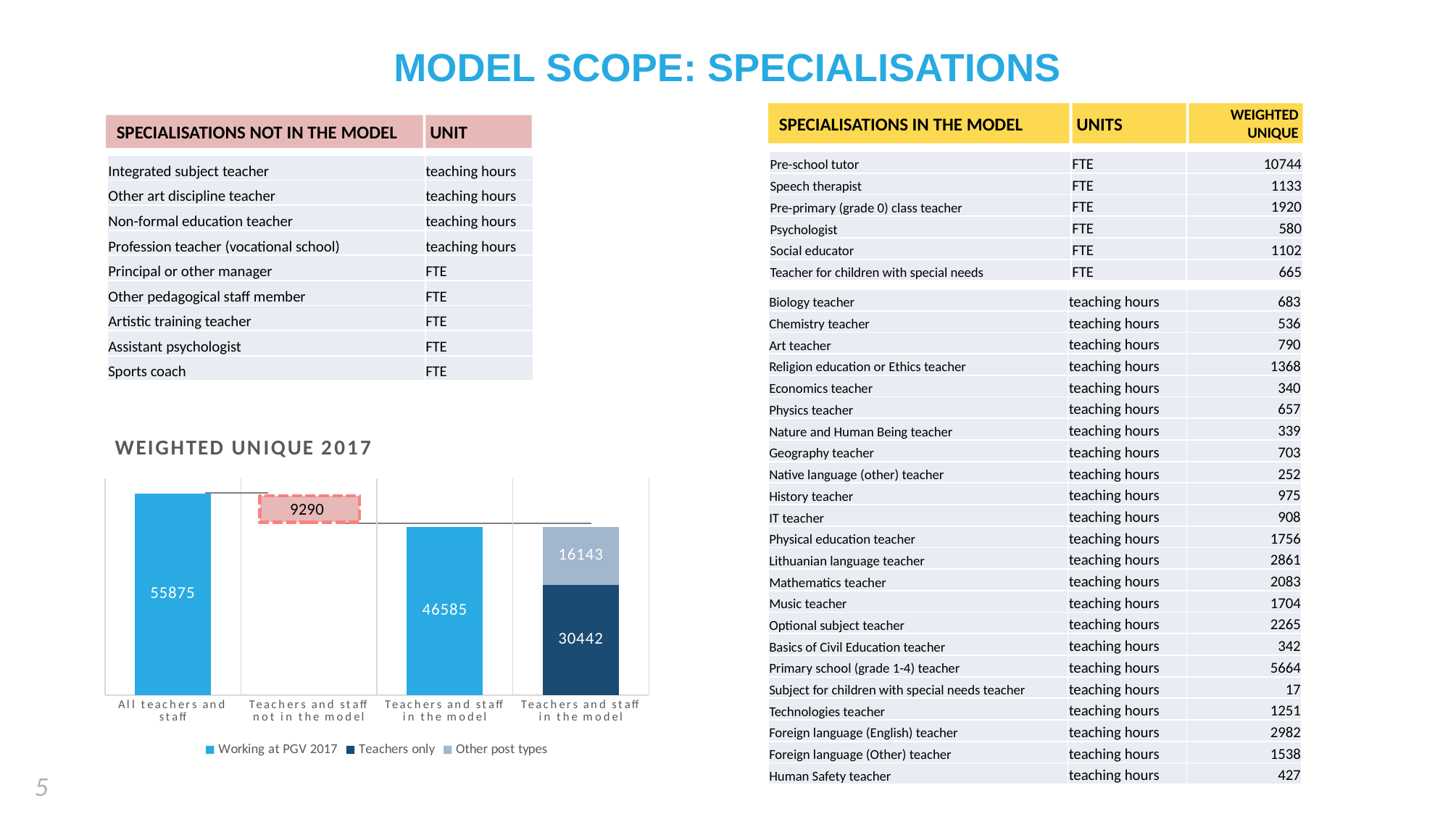
In the WEIGHTED UNIQUE 2017 chart, what is the difference between the Teachers only segment and the Other post types segment? 14299 How many series does the legend of the WEIGHTED UNIQUE 2017 chart list? 3 In the WEIGHTED UNIQUE 2017 chart, what is the value of the Other post types segment in the stacked bar? 16143 In the WEIGHTED UNIQUE 2017 chart, what is the value for Teachers and staff not in the model? 9290 In the WEIGHTED UNIQUE 2017 chart, what is the difference between All teachers and staff (55875) and the single blue bar for Teachers and staff in the model (46585)? 9290 In the WEIGHTED UNIQUE 2017 chart, what is the value of the Teachers only segment in the stacked bar? 30442 How many categories are shown on the x axis of the WEIGHTED UNIQUE 2017 chart? 4 In the WEIGHTED UNIQUE 2017 chart, which segment of the stacked bar is larger, Teachers only or Other post types? Teachers only In the WEIGHTED UNIQUE 2017 chart, what is the value for All teachers and staff? 55875 In the WEIGHTED UNIQUE 2017 chart, which category has the highest bar? All teachers and staff What kind of chart is the WEIGHTED UNIQUE 2017 chart? Bar chart In the WEIGHTED UNIQUE 2017 chart, what is the total of the stacked bar (Teachers only plus Other post types)? 46585